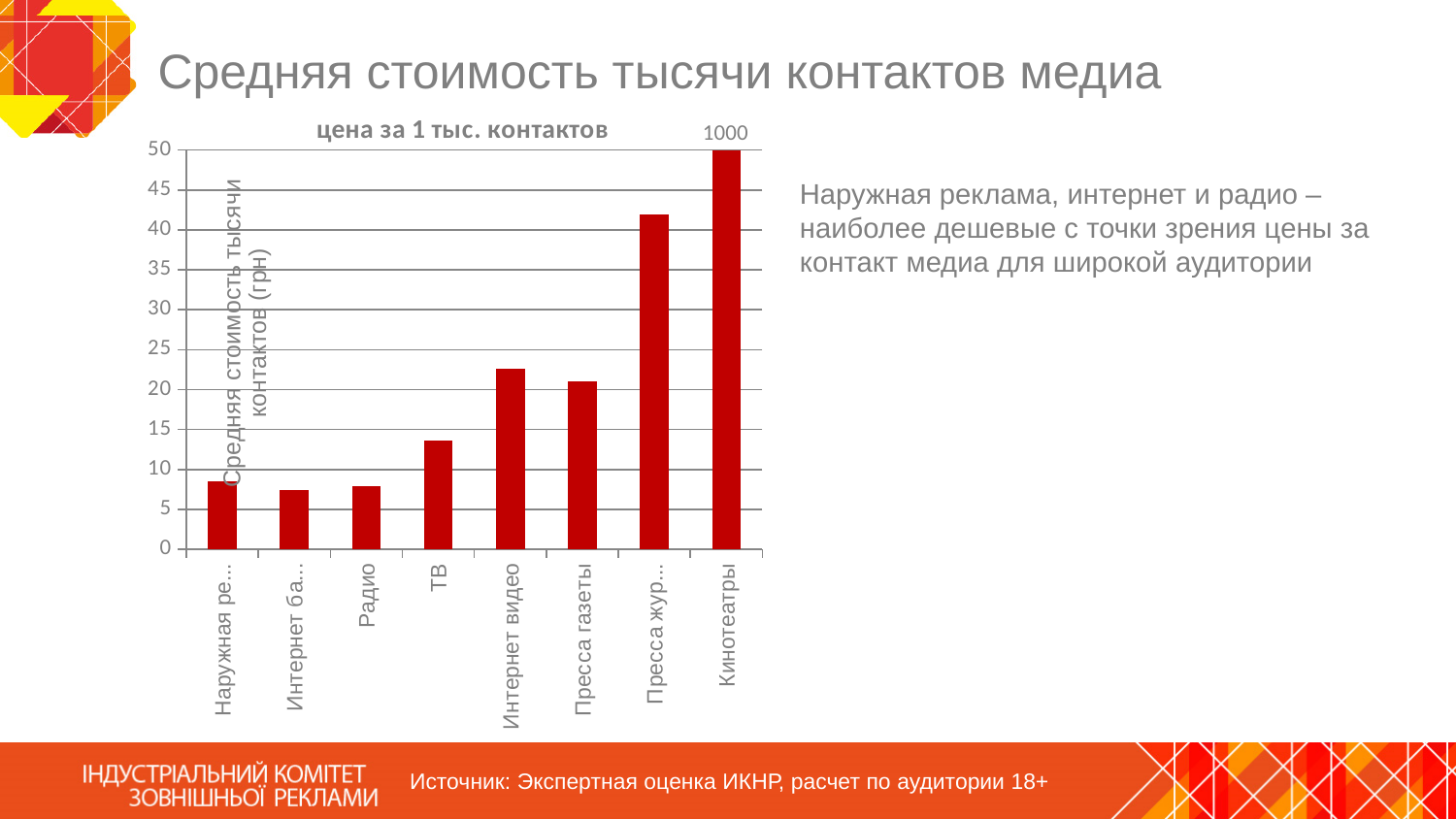
Is the value for Интернет видео greater or less than 20? greater Which is larger, the value for Пресса жур... or the value for Интернет видео? Пресса жур... Is the value for Радио greater or less than 10? less How many categories (media types) are plotted in the chart? 8 Do the values generally rise or fall from left to right along the x axis? rise What kind of chart is shown on the slide? bar chart What is the title of the chart? цена за 1 тыс. контактов Is the value for ТВ greater or less than 10? greater What is the value shown for Кинотеатры? 1000 Which is larger, the value for ТВ or the value for Радио? ТВ Which category has the highest value in the chart? Кинотеатры